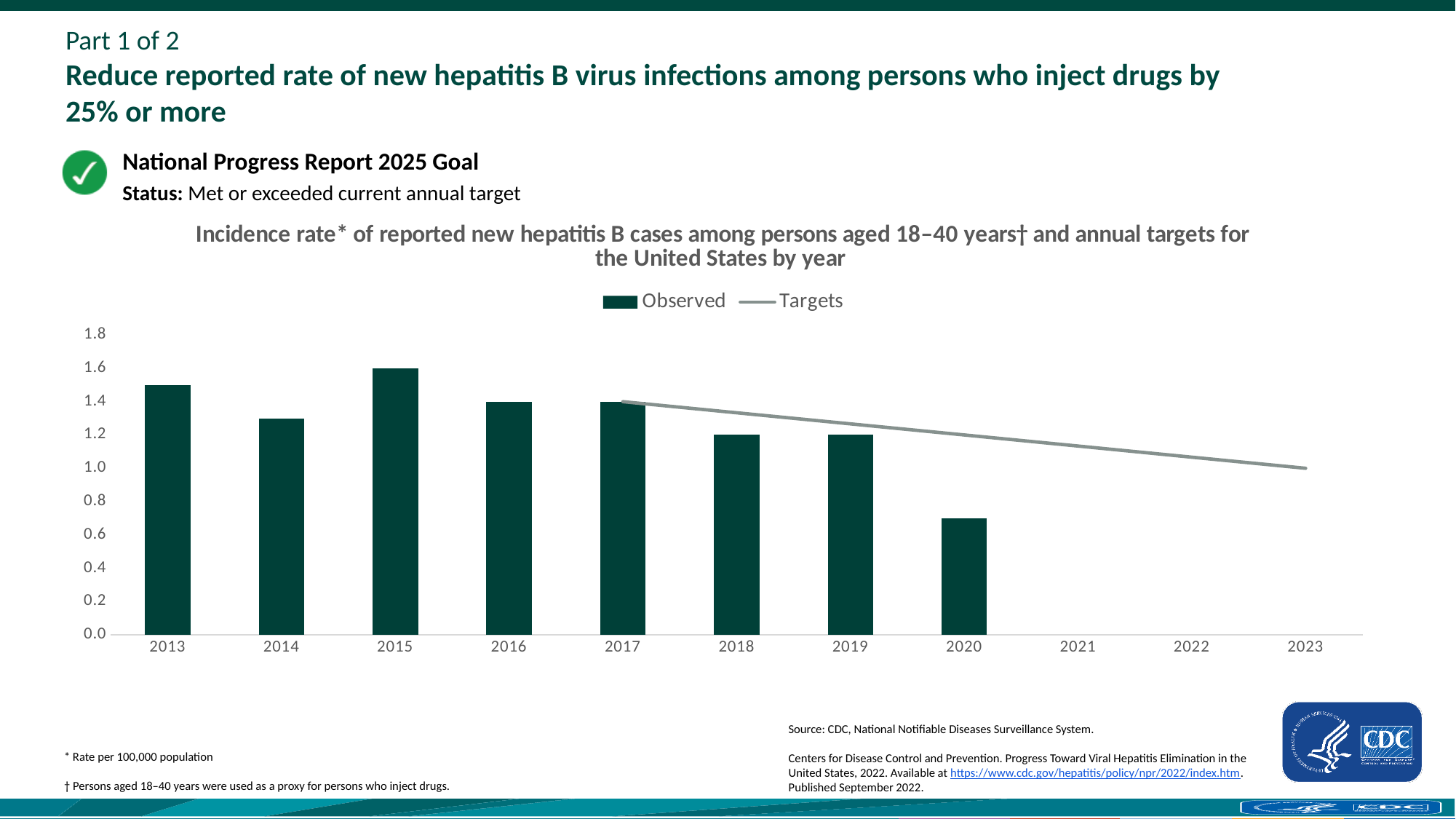
Is the observed value for 2015 greater or less than 1.4? greater What kind of chart is used to show the observed values? Bar chart Do the observed values rise or fall from 2017 to 2020? Fall Is the observed value for 2018 greater or less than 1.4? less Which year has the highest observed incidence rate? 2015 How many years have an observed bar plotted? 8 Which year has the lowest observed incidence rate? 2020 Is the observed value for 2013 greater or less than 1.4? greater Which year has a higher observed value, 2018 or 2020? 2018 Which year has a higher observed value, 2013 or 2014? 2013 How many series does the legend list? 2